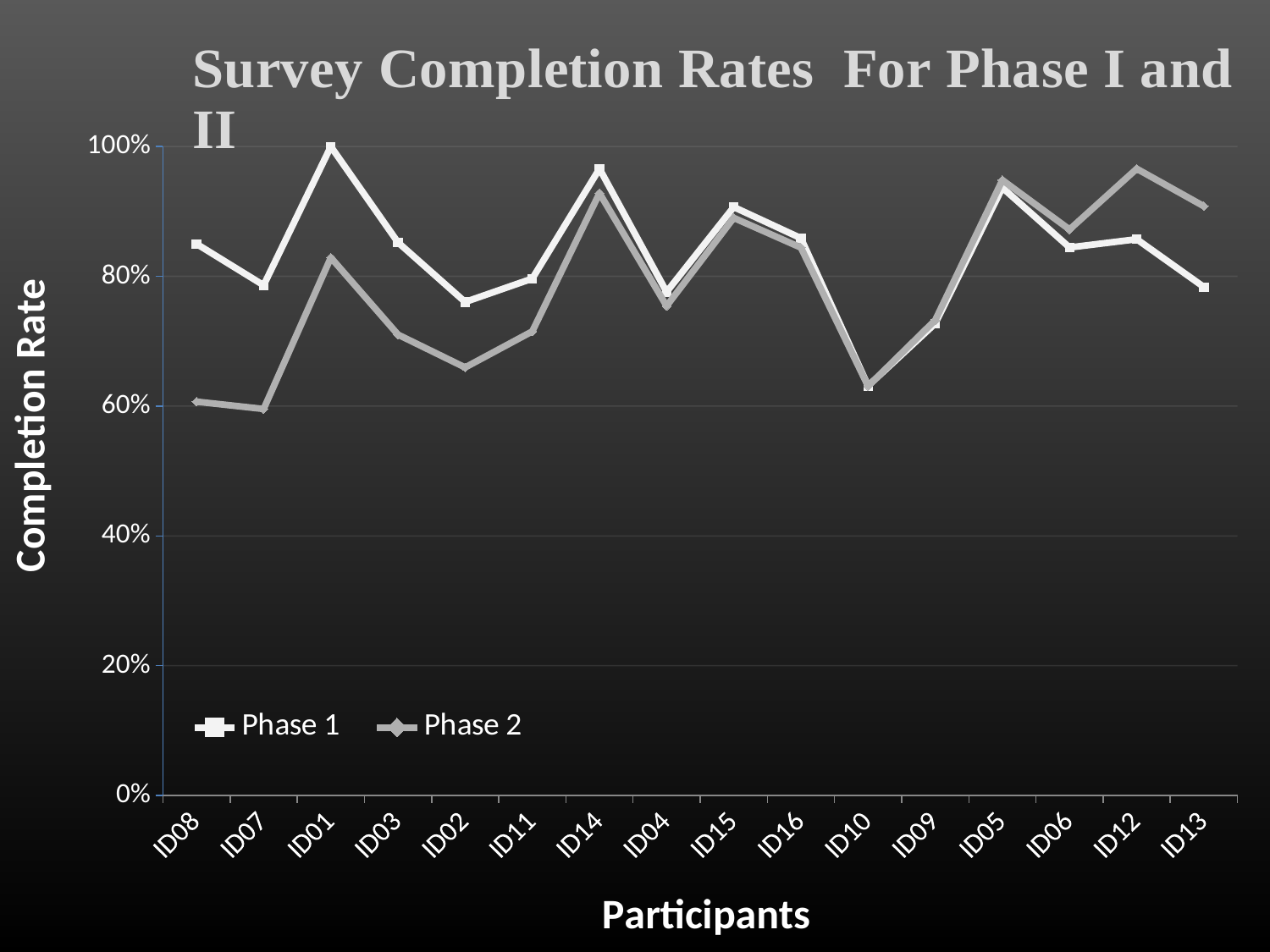
Is the Phase 1 value for ID15 greater or less than 80%? greater What type of chart is shown on the slide? line chart What is the Phase 1 completion rate for ID01? 100% What is the label on the y axis? Completion Rate Which participant has the lowest Phase 1 completion rate? ID10 Which participant has the highest Phase 1 completion rate? ID01 Is the Phase 2 value for ID08 greater or less than 80%? less For ID13, which is larger, the Phase 1 or the Phase 2 value? Phase 2 Does the Phase 2 line rise or fall from ID01 to ID02? fall How many participants are shown on the x axis? 16 For ID08, which is larger, the Phase 1 or the Phase 2 value? Phase 1 How many series does the legend list? 2